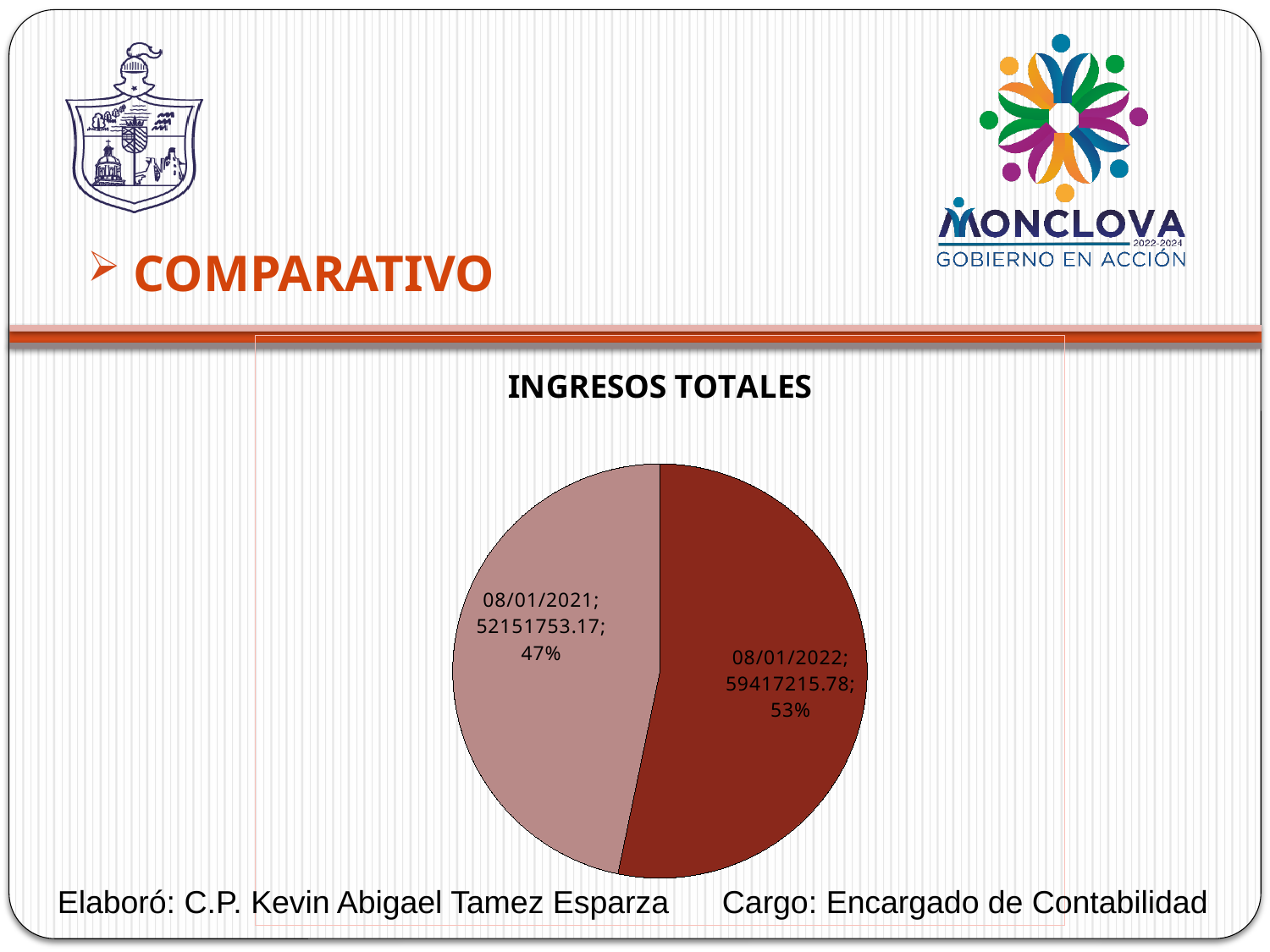
How many slices does the INGRESOS TOTALES pie chart have? 2 Which slice of the INGRESOS TOTALES pie chart is coloured dark red? 08/01/2022 What kind of chart is shown under the title INGRESOS TOTALES? pie chart What share of the INGRESOS TOTALES pie does the 08/01/2021 slice represent? 47% What is the title of the pie chart on the slide? INGRESOS TOTALES Which is larger in the INGRESOS TOTALES pie chart, the value for 08/01/2021 or for 08/01/2022? 08/01/2022 Which slice is the largest in the INGRESOS TOTALES pie chart? 08/01/2022 Which slice is the smallest in the INGRESOS TOTALES pie chart? 08/01/2021 What is the value for 08/01/2022 in the INGRESOS TOTALES pie chart? 59417215.78 What is the value for 08/01/2021 in the INGRESOS TOTALES pie chart? 52151753.17 What is the difference between the values for 08/01/2022 and 08/01/2021 in the INGRESOS TOTALES pie chart? 7265462.61 What share of the INGRESOS TOTALES pie does the 08/01/2022 slice represent? 53%